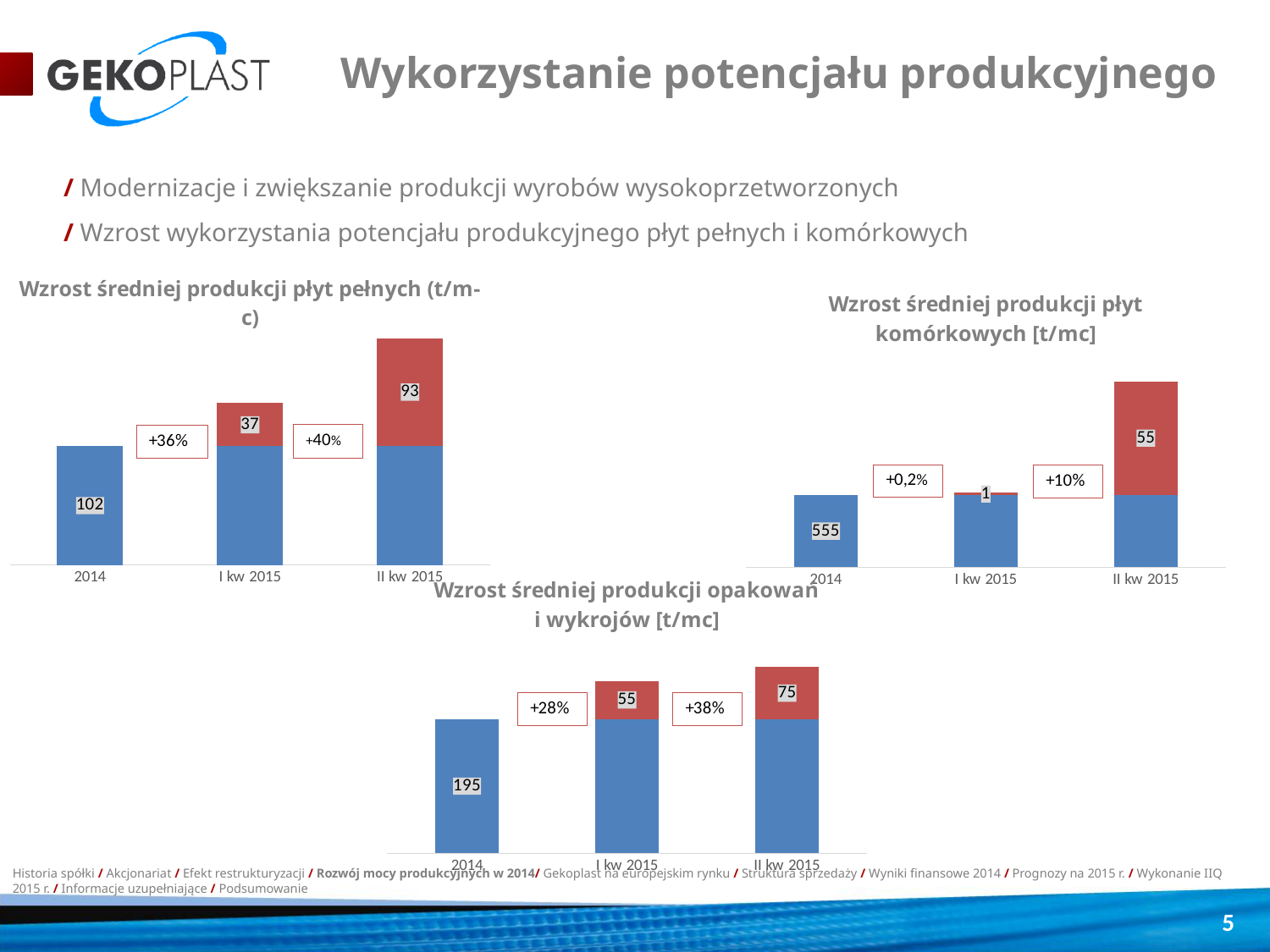
How many periods are shown on the x axis of the chart 'Wzrost średniej produkcji płyt pełnych (t/m-c)'? 3 In the chart 'Wzrost średniej produkcji płyt komórkowych [t/mc]', what value is labelled on the red segment of the II kw 2015 bar? 55 In the chart 'Wzrost średniej produkcji płyt pełnych (t/m-c)', do the bar heights rise or fall from 2014 to II kw 2015? Rise In the chart 'Wzrost średniej produkcji płyt komórkowych [t/mc]', what value is labelled on the 2014 bar? 555 In the chart 'Wzrost średniej produkcji opakowań i wykrojów [t/mc]', what percentage change is shown between 2014 and I kw 2015? +28% In the chart 'Wzrost średniej produkcji płyt pełnych (t/m-c)', what value is labelled on the red segment of the II kw 2015 bar? 93 In the chart 'Wzrost średniej produkcji płyt pełnych (t/m-c)', what value is labelled on the 2014 bar? 102 In the chart 'Wzrost średniej produkcji płyt pełnych (t/m-c)', what percentage change is shown between 2014 and I kw 2015? +36% What kind of chart is 'Wzrost średniej produkcji opakowań i wykrojów [t/mc]'? Bar chart In the chart 'Wzrost średniej produkcji płyt komórkowych [t/mc]', what percentage change is shown between I kw 2015 and II kw 2015? +10% In the chart 'Wzrost średniej produkcji opakowań i wykrojów [t/mc]', which period has the tallest bar? II kw 2015 In the chart 'Wzrost średniej produkcji opakowań i wykrojów [t/mc]', what value is labelled on the 2014 bar? 195